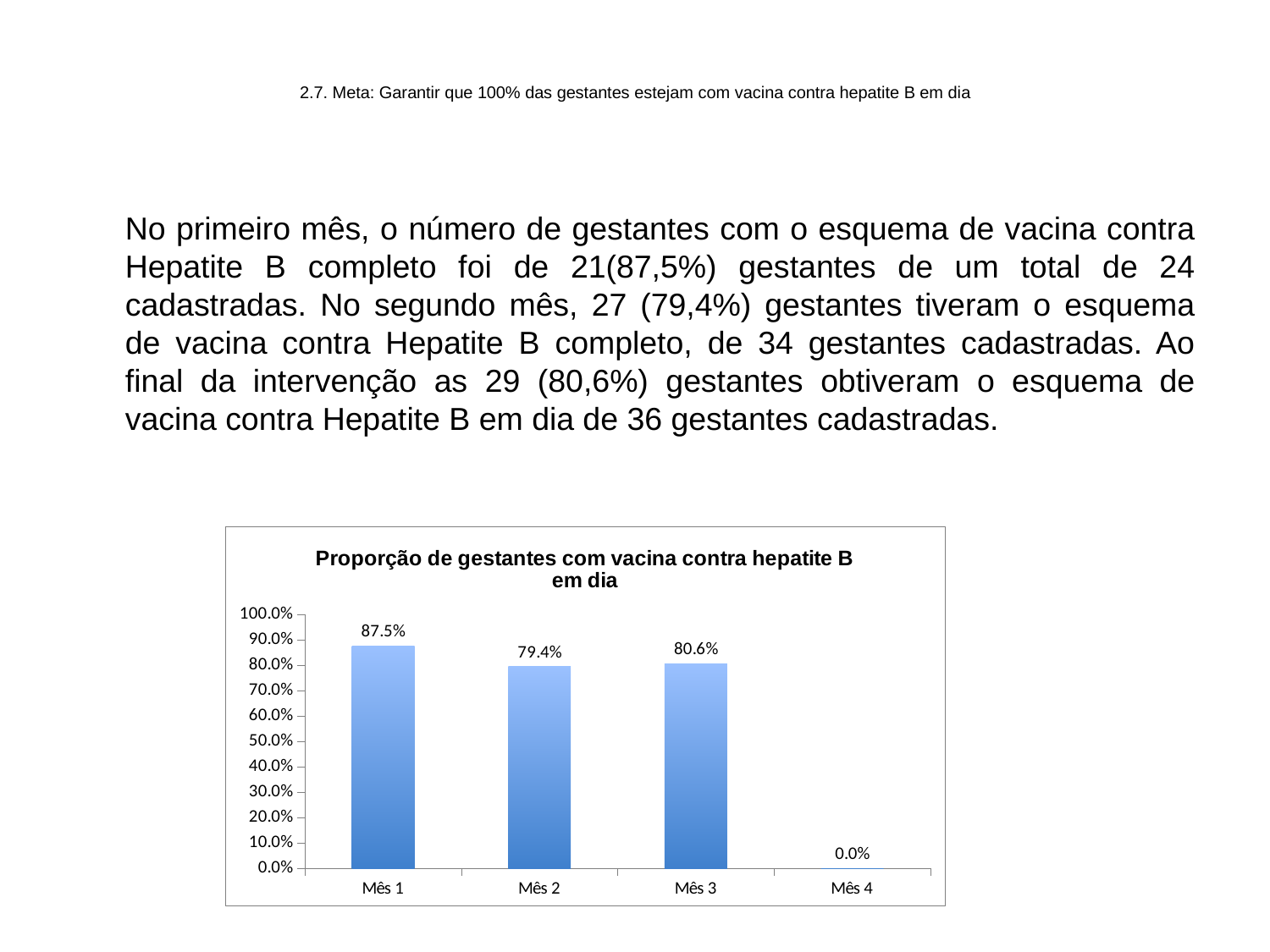
What is the difference between the values for Mês 1 and Mês 2? 8.1% What is the title of the chart? Proporção de gestantes com vacina contra hepatite B em dia What is the value for Mês 1? 87.5% Which month has the lowest value? Mês 4 What kind of chart is shown? Bar chart What is the value for Mês 4? 0.0% Is the value for Mês 1 greater or less than 80.0%? greater Which is larger, the value for Mês 2 or Mês 3? Mês 3 What is the value for Mês 3? 80.6% How many categories are shown on the x axis? 4 What is the value for Mês 2? 79.4% Which month has the highest value? Mês 1